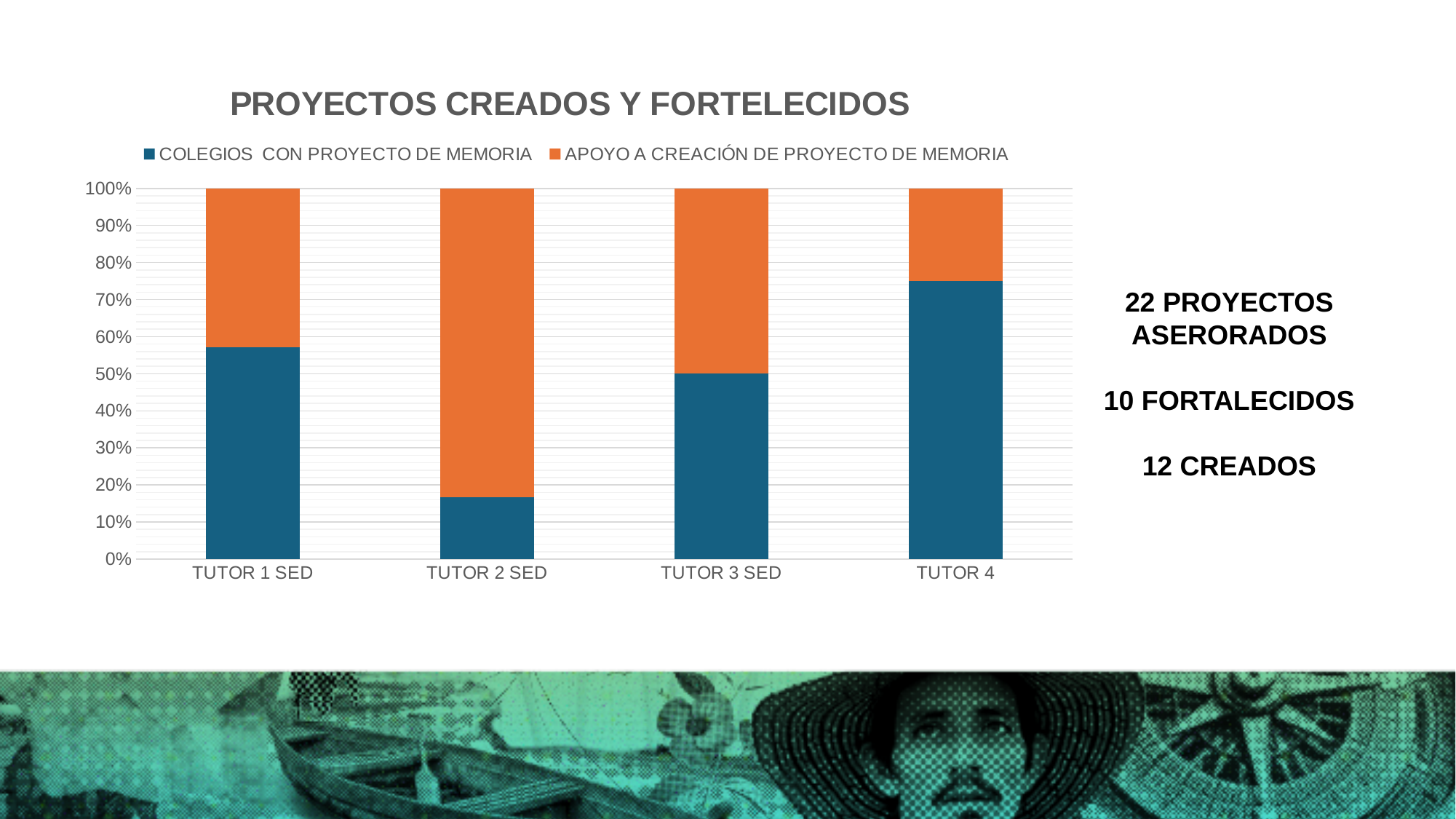
Which has a larger COLEGIOS CON PROYECTO DE MEMORIA share, TUTOR 1 SED or TUTOR 3 SED? TUTOR 1 SED Is the COLEGIOS CON PROYECTO DE MEMORIA share for TUTOR 4 greater or less than 70%? greater What kind of chart is shown on the slide? Stacked bar chart Which tutor has the highest share for COLEGIOS CON PROYECTO DE MEMORIA? TUTOR 4 How many series does the legend list? 2 What is the title of the chart? PROYECTOS CREADOS Y FORTELECIDOS Is the COLEGIOS CON PROYECTO DE MEMORIA share for TUTOR 1 SED greater or less than 50%? greater Is the COLEGIOS CON PROYECTO DE MEMORIA share for TUTOR 2 SED greater or less than 20%? less Which colour represents APOYO A CREACIÓN DE PROYECTO DE MEMORIA in the chart? Orange Which tutor has the lowest share for COLEGIOS CON PROYECTO DE MEMORIA? TUTOR 2 SED Which tutor has the highest share for APOYO A CREACIÓN DE PROYECTO DE MEMORIA? TUTOR 2 SED How many tutor categories are shown on the x axis? 4